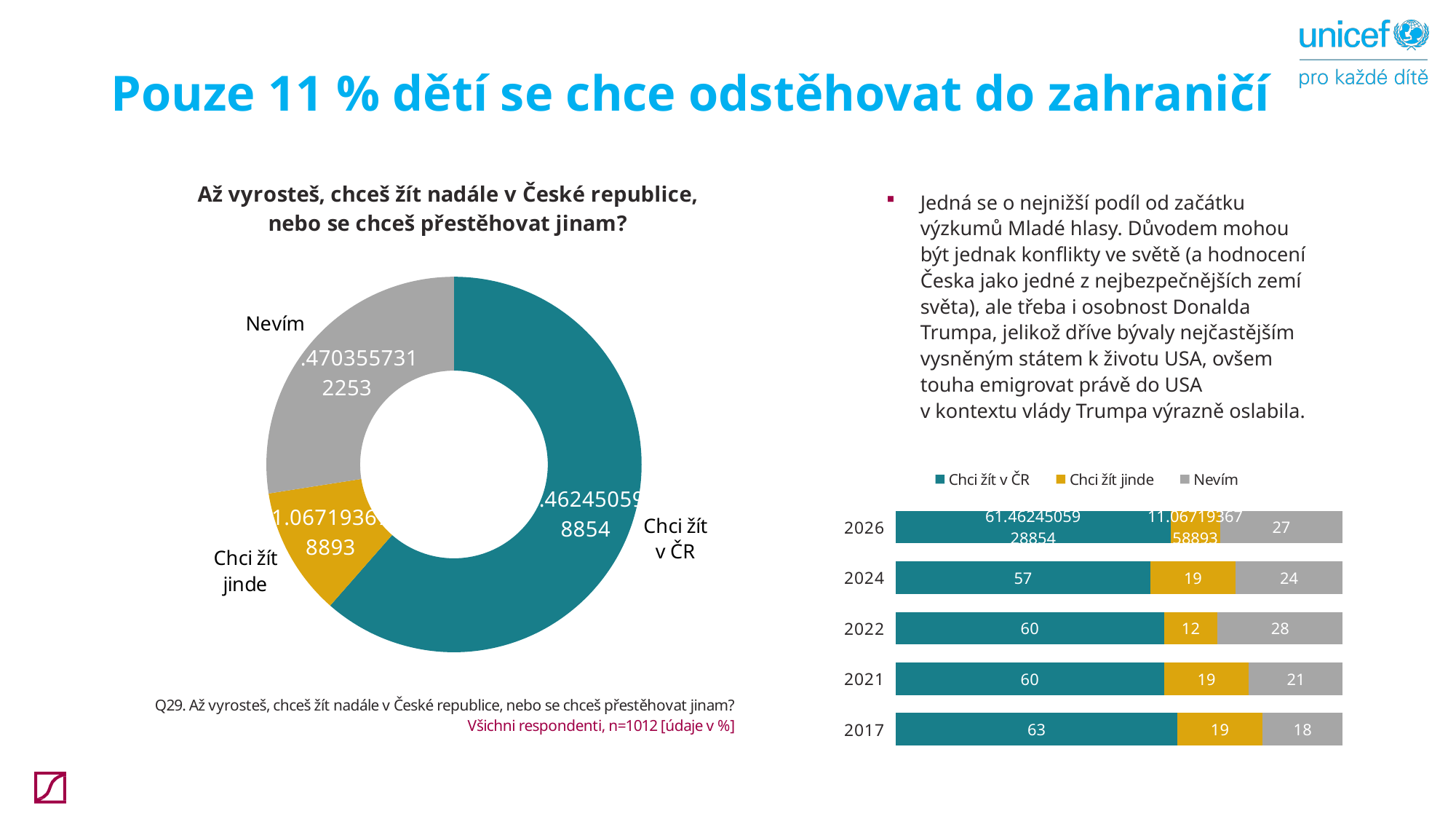
In the bar chart on the right, what is the total of the stacked bar for 2024? 100 In the pie chart on the left, which category has the largest slice? Chci žít v ČR In the bar chart on the right, what is the difference between the 'Nevím' values for 2024 and 2021? 3 What kind of chart is the chart on the right of the slide? bar chart In the bar chart on the right, what is the value for 'Chci žít jinde' in 2022? 12 In the bar chart on the right, which year has the lowest value for 'Nevím'? 2017 In the bar chart on the right, which year has the highest value for 'Chci žít v ČR'? 2017 In the bar chart on the right, what is the value for 'Chci žít v ČR' in 2024? 57 In the bar chart on the right, what is the value for 'Nevím' in 2017? 18 What kind of chart is the chart on the left of the slide? doughnut chart In the bar chart on the right, how many years are shown? 5 In the bar chart on the right, how many series does the legend list? 3